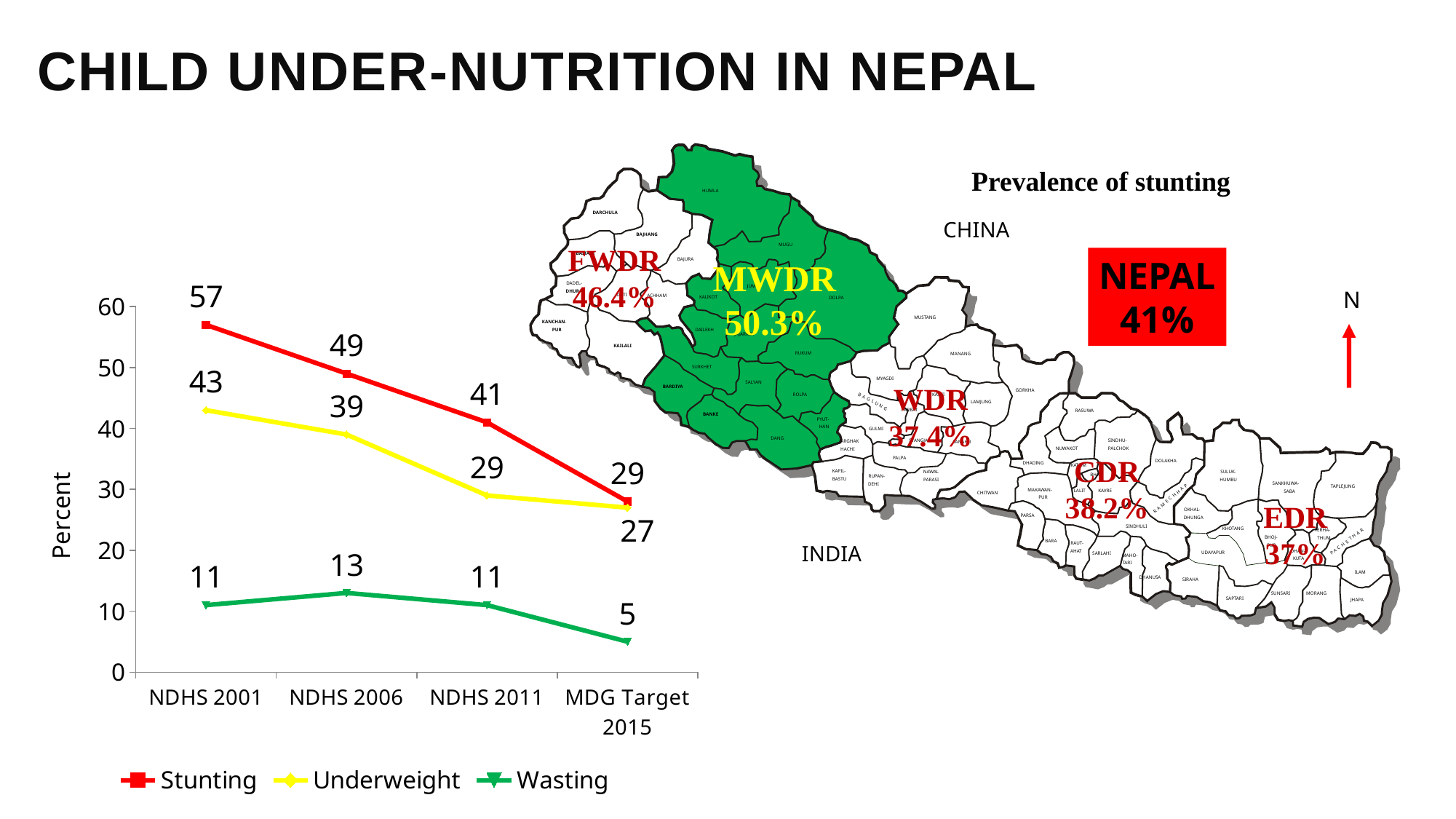
What is the Stunting value for NDHS 2001? 57 At which x-axis category is the Wasting series highest? NDHS 2006 Which is larger at NDHS 2001: the Stunting value or the Underweight value? Stunting At which x-axis category is the Stunting series lowest? MDG Target 2015 Does the Stunting series rise or fall from NDHS 2001 to MDG Target 2015? Fall What is the Underweight value for NDHS 2006? 39 What is the difference between the Stunting and Underweight values for NDHS 2011? 12 What is the Wasting value for the MDG Target 2015? 5 How many series does the legend of the line chart list? 3 What kind of chart is shown on the left of the slide? Line chart How many categories are shown on the x axis of the line chart? 4 What is the Underweight value for the MDG Target 2015? 27